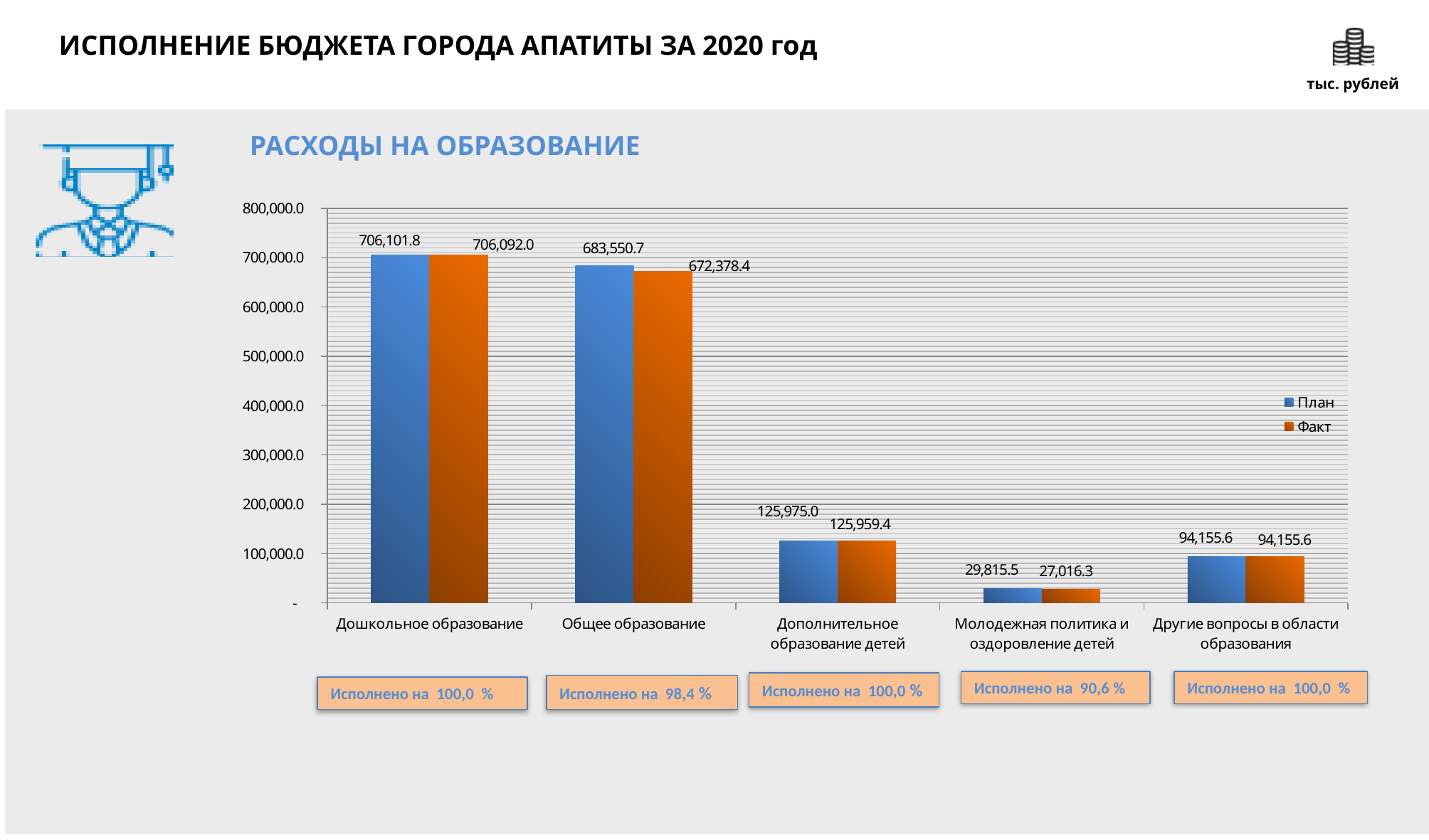
What kind of chart is shown on the slide? Bar chart What is the difference between the План and Факт values for Общее образование? 11,172.3 What is the План value for Дошкольное образование? 706,101.8 What is the Факт value for Молодежная политика и оздоровление детей? 27,016.3 Which category has the highest План value? Дошкольное образование Which is larger for Дополнительное образование детей: the План value or the Факт value? План Which category has the lowest Факт value? Молодежная политика и оздоровление детей What is the Факт value for Общее образование? 672,378.4 How many series does the legend list? 2 What is the title of the chart? РАСХОДЫ НА ОБРАЗОВАНИЕ How many categories are shown on the x axis? 5 What is the План value for Другие вопросы в области образования? 94,155.6